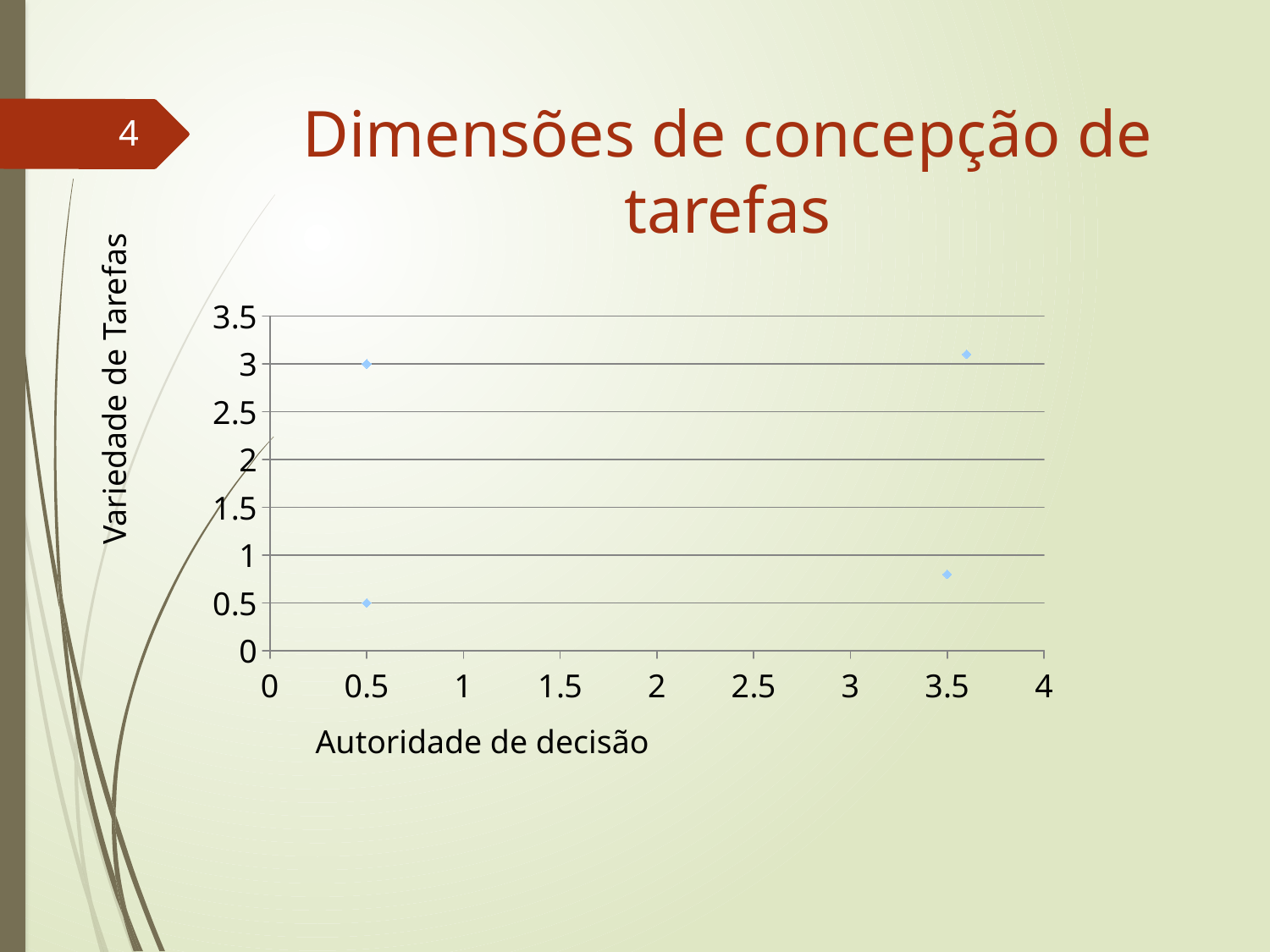
What is the title of the chart? Dimensões de concepção de tarefas Which point has the lowest Variedade de Tarefas value: the lower-left point or the lower-right point? the lower-left point Is the Autoridade de decisão value of the two right-hand points greater or less than 3? greater Is the Variedade de Tarefas value of the upper-right point greater or less than 2? greater Is the Variedade de Tarefas value of the lower-right point greater or less than 1? less What is the maximum value shown on the vertical axis? 3.5 Which point has the highest Variedade de Tarefas value: the upper-left point or the upper-right point? the upper-right point What kind of chart is shown on the slide? scatter chart How many data points are plotted on the chart? 4 What is the label of the horizontal axis? Autoridade de decisão